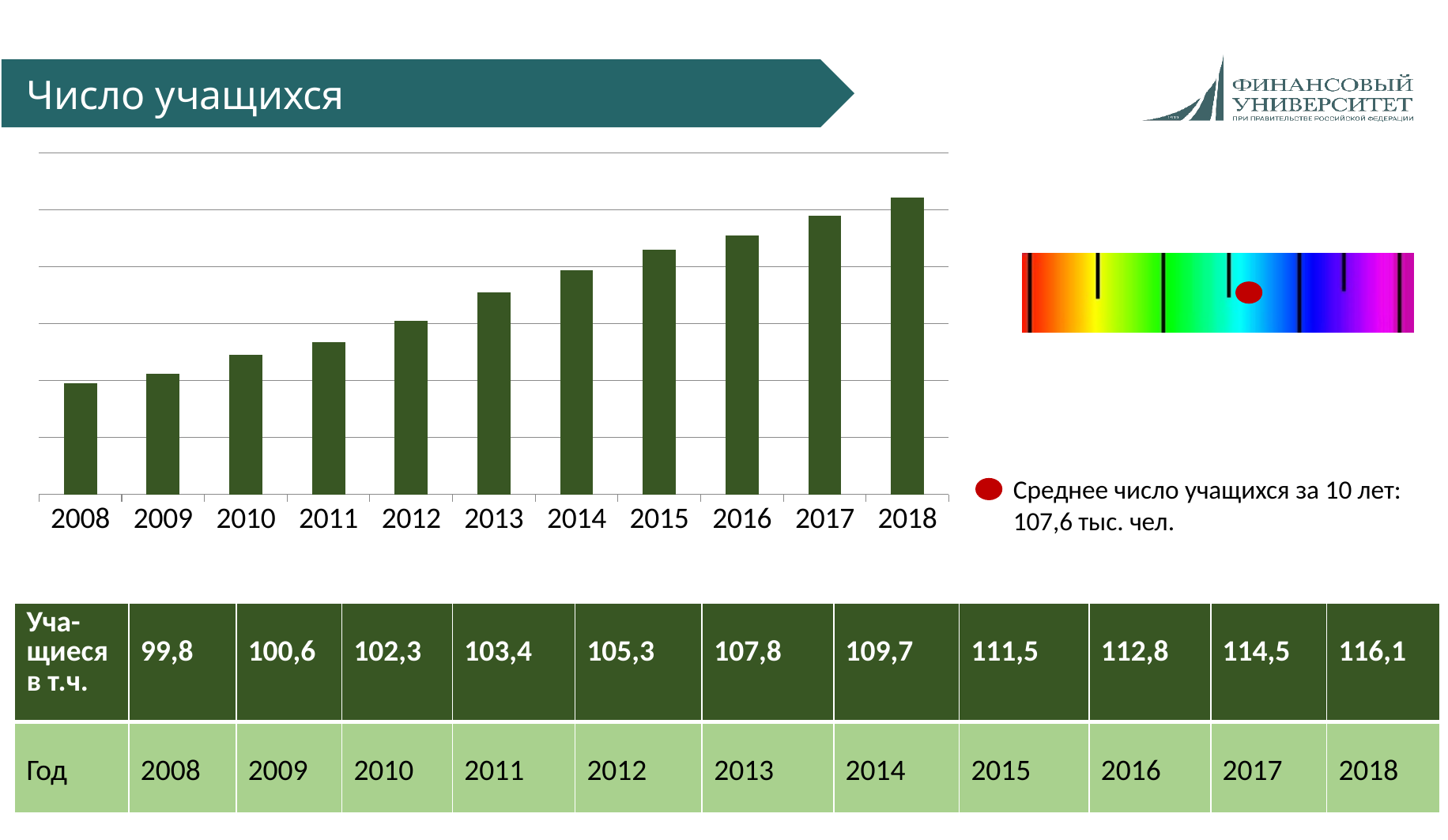
According to the table under the chart, what is the number of students in 2008? 99,8 What is the average number of students over 10 years stated on the slide? 107,6 тыс. чел. Using the table values, what is the difference between the number of students in 2018 and in 2008? 16,3 Which year has the lowest number of students? 2008 Which year has the highest number of students? 2018 What is the title of the chart? Число учащихся Which year has a larger number of students, 2012 or 2015? 2015 Do the values rise or fall from 2008 to 2018? rise What kind of chart is shown on the slide? bar chart How many years (bars) are shown in the chart? 11 According to the table under the chart, what is the number of students in 2018? 116,1 According to the table under the chart, what is the number of students in 2013? 107,8